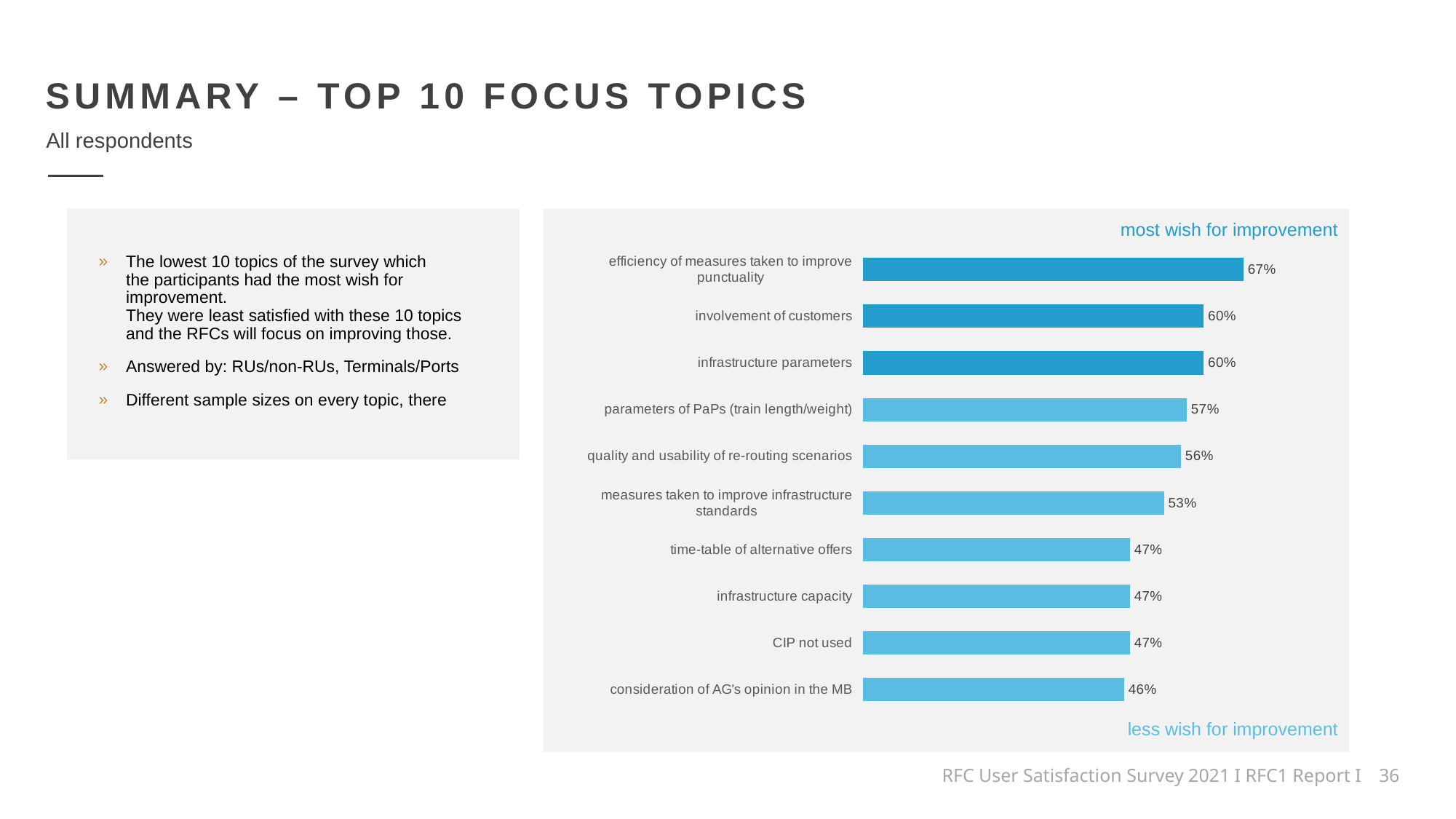
What label appears at the top of the chart above the bars? most wish for improvement How many topics are shown in the chart? 10 What kind of chart is shown on the slide? bar chart Which topic has the highest value? efficiency of measures taken to improve punctuality What is the value for 'consideration of AG's opinion in the MB'? 46% What is the difference between 'efficiency of measures taken to improve punctuality' and 'involvement of customers'? 7% What is the value for 'measures taken to improve infrastructure standards'? 53% What is the difference between 'parameters of PaPs (train length/weight)' and 'CIP not used'? 10% Which topic has the lowest value? consideration of AG's opinion in the MB What is the value for 'quality and usability of re-routing scenarios'? 56% What is the value for 'efficiency of measures taken to improve punctuality'? 67% Which is larger, 'infrastructure parameters' or 'time-table of alternative offers'? infrastructure parameters